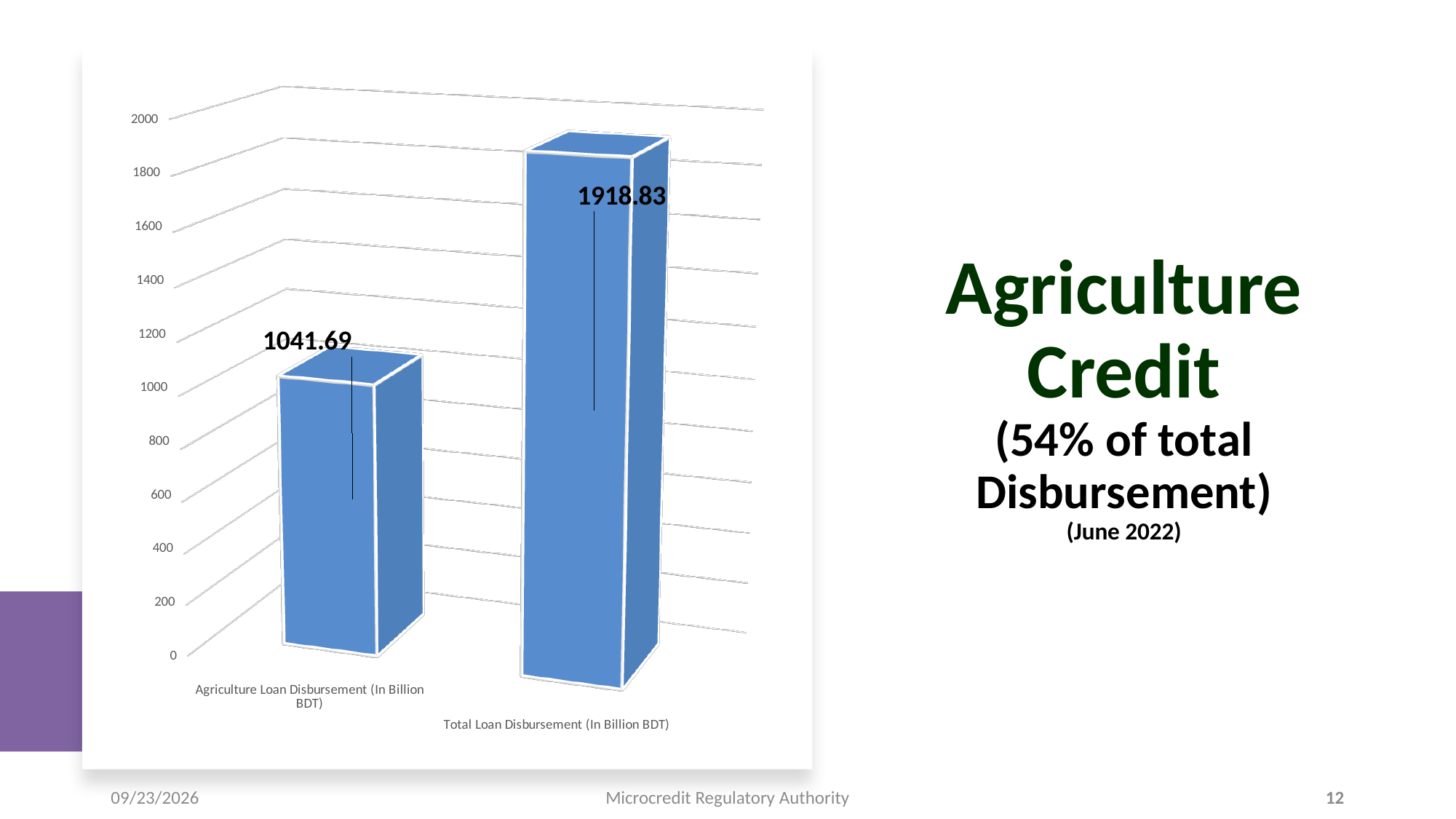
Which category has the lowest value? Agriculture Loan Disbursement (In Billion BDT) Is the value for Total Loan Disbursement greater or less than 1800? greater Which is larger, Agriculture Loan Disbursement or Total Loan Disbursement? Total Loan Disbursement (In Billion BDT) What is the difference between Total Loan Disbursement and Agriculture Loan Disbursement? 877.14 What kind of chart is shown on the slide? bar chart How many categories are shown in the chart? 2 What is the maximum value shown on the vertical axis? 2000 What is the value for Total Loan Disbursement (In Billion BDT)? 1918.83 What colour are the bars in the chart? blue What is the value for Agriculture Loan Disbursement (In Billion BDT)? 1041.69 Which category has the highest value? Total Loan Disbursement (In Billion BDT) Is the value for Agriculture Loan Disbursement greater or less than 1200? less